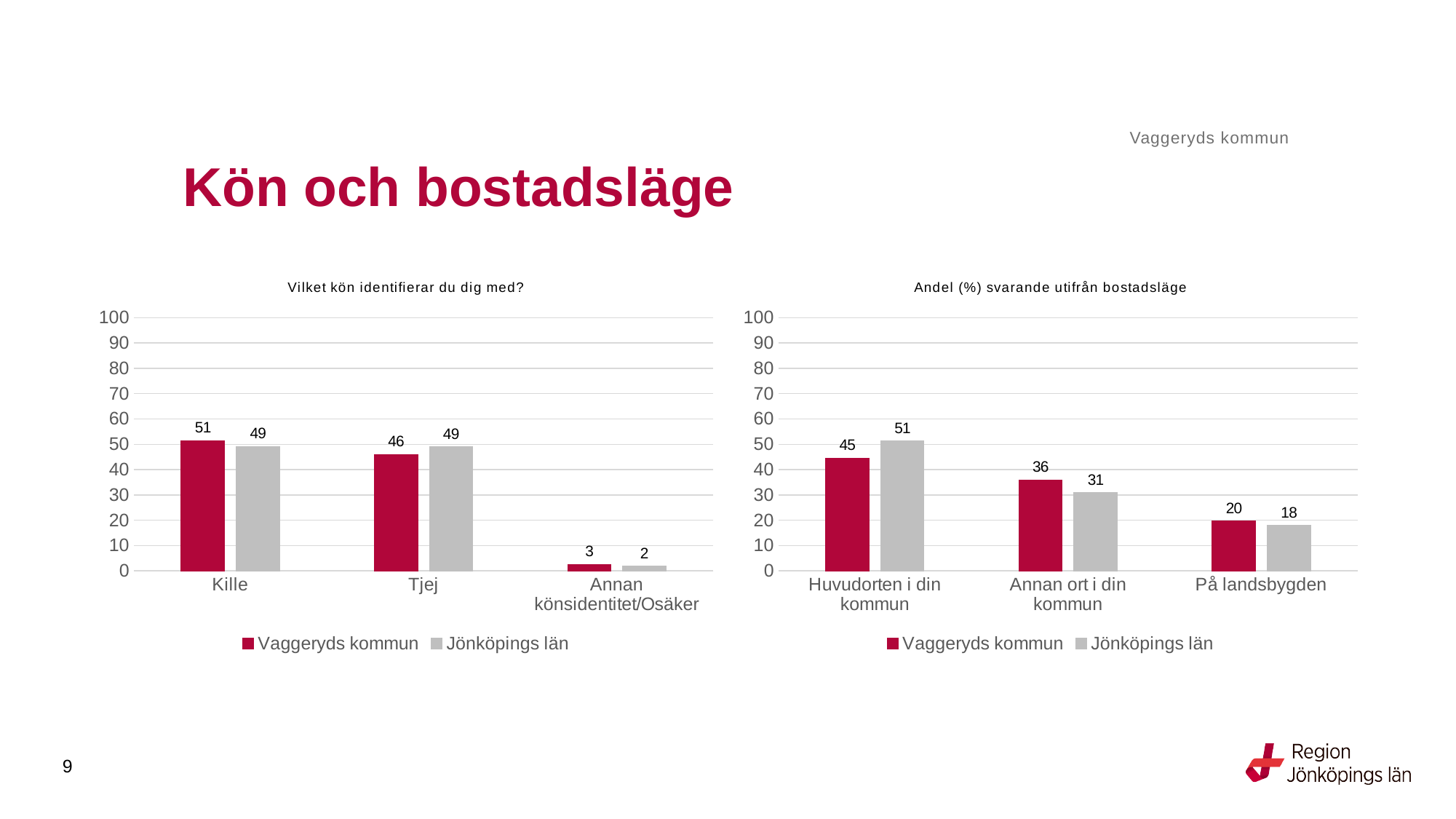
In the chart 'Andel (%) svarande utifrån bostadsläge', which is larger for Huvudorten i din kommun: Vaggeryds kommun or Jönköpings län? Jönköpings län In the chart 'Vilket kön identifierar du dig med?', what is the value for Vaggeryds kommun for Kille? 51 In the chart 'Andel (%) svarande utifrån bostadsläge', what is the difference between Vaggeryds kommun and Jönköpings län for Annan ort i din kommun? 5 In the chart 'Andel (%) svarande utifrån bostadsläge', what is the value for Vaggeryds kommun for Annan ort i din kommun? 36 In the chart 'Vilket kön identifierar du dig med?', how many categories are shown on the x axis? 3 In the chart 'Andel (%) svarande utifrån bostadsläge', how many series does the legend list? 2 In the chart 'Vilket kön identifierar du dig med?', what is the value for Jönköpings län for Tjej? 49 What kind of chart is the chart on the right of the slide? Bar chart In the chart 'Vilket kön identifierar du dig med?', which category has the lowest value for Vaggeryds kommun? Annan könsidentitet/Osäker In the chart 'Vilket kön identifierar du dig med?', what is the difference between Vaggeryds kommun and Jönköpings län for Tjej? 3 In the chart 'Andel (%) svarande utifrån bostadsläge', which category has the highest value for Jönköpings län? Huvudorten i din kommun In the chart 'Andel (%) svarande utifrån bostadsläge', what is the value for Jönköpings län for På landsbygden? 18